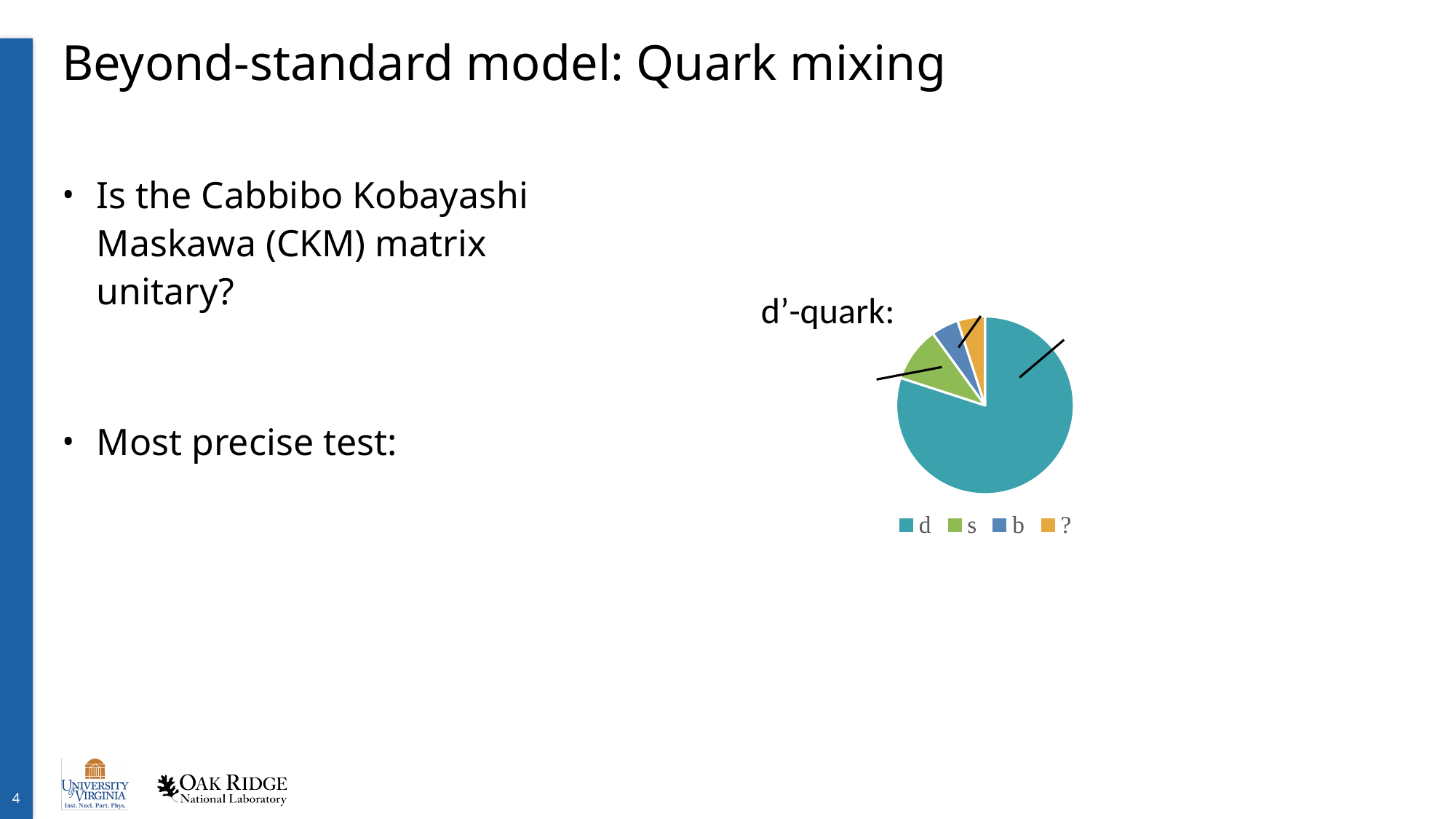
Which slice of the pie chart is the largest? d What kind of chart is shown on the slide? pie chart Which is larger in the pie chart, the slice for d or the slice for s? d Which is larger in the pie chart, the slice for s or the slice for ? s What are the legend entries of the pie chart, in order? d, s, b, ? How many entries does the legend of the pie chart list? 4 What label appears next to the pie chart? d'-quark: How many slices does the pie chart have? 4 Which is larger in the pie chart, the slice for s or the slice for b? s